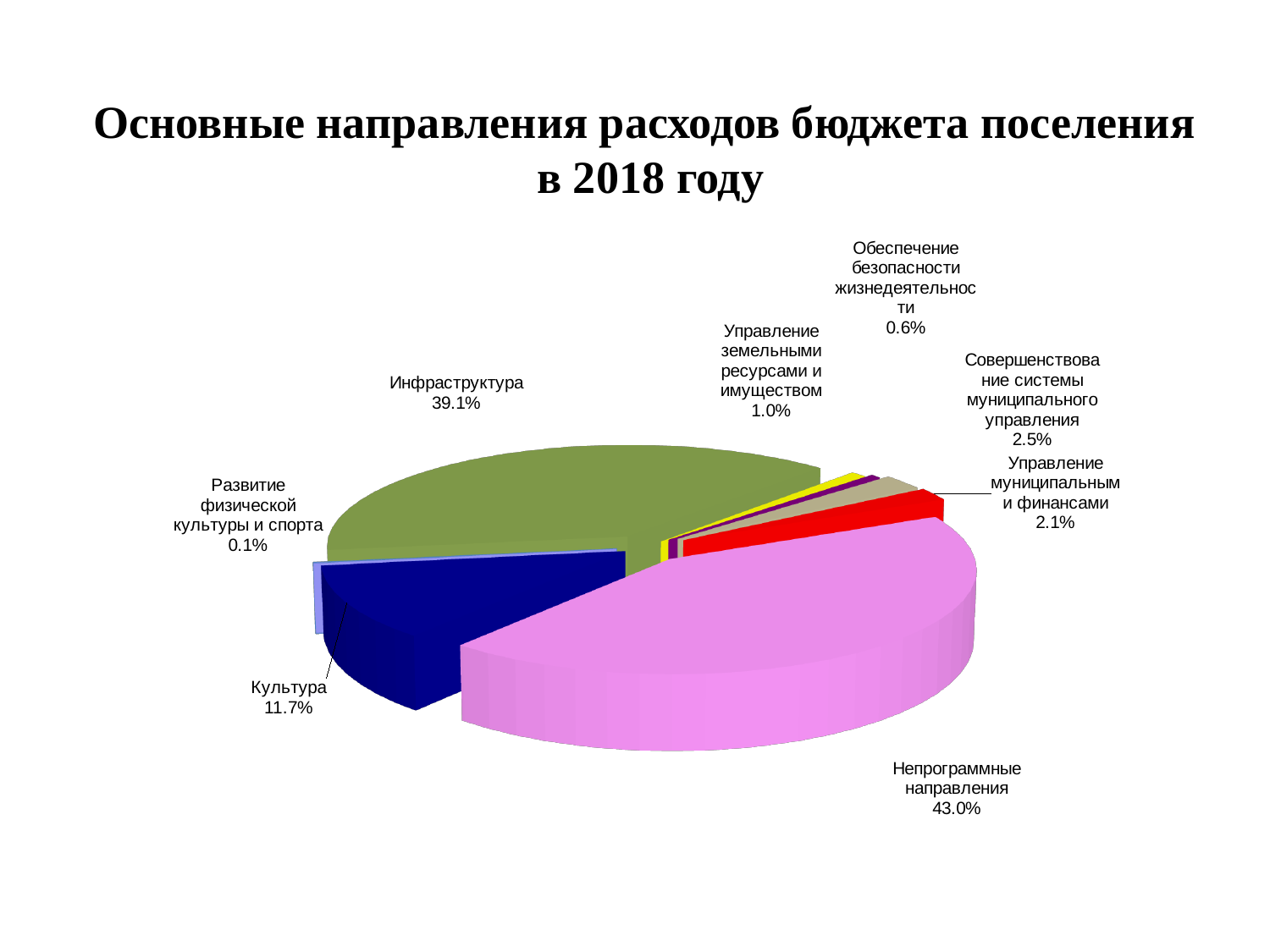
Which is larger: the share for Управление муниципальными финансами or the share for Управление земельными ресурсами и имуществом? Управление муниципальными финансами What is the title of the slide? Основные направления расходов бюджета поселения в 2018 году What share of the pie does Непрограммные направления have? 43.0% What is the value shown for Совершенствование системы муниципального управления? 2.5% What is the value shown for Культура? 11.7% Which category has the smallest share of the pie? Развитие физической культуры и спорта What is the value shown for Обеспечение безопасности жизнедеятельности? 0.6% What type of chart is shown on the slide? Pie chart Which category has the largest share of the pie? Непрограммные направления How many categories are shown in the pie chart? 8 What share of the pie does Инфраструктура have? 39.1% What is the difference between the shares of Непрограммные направления and Инфраструктура? 3.9%